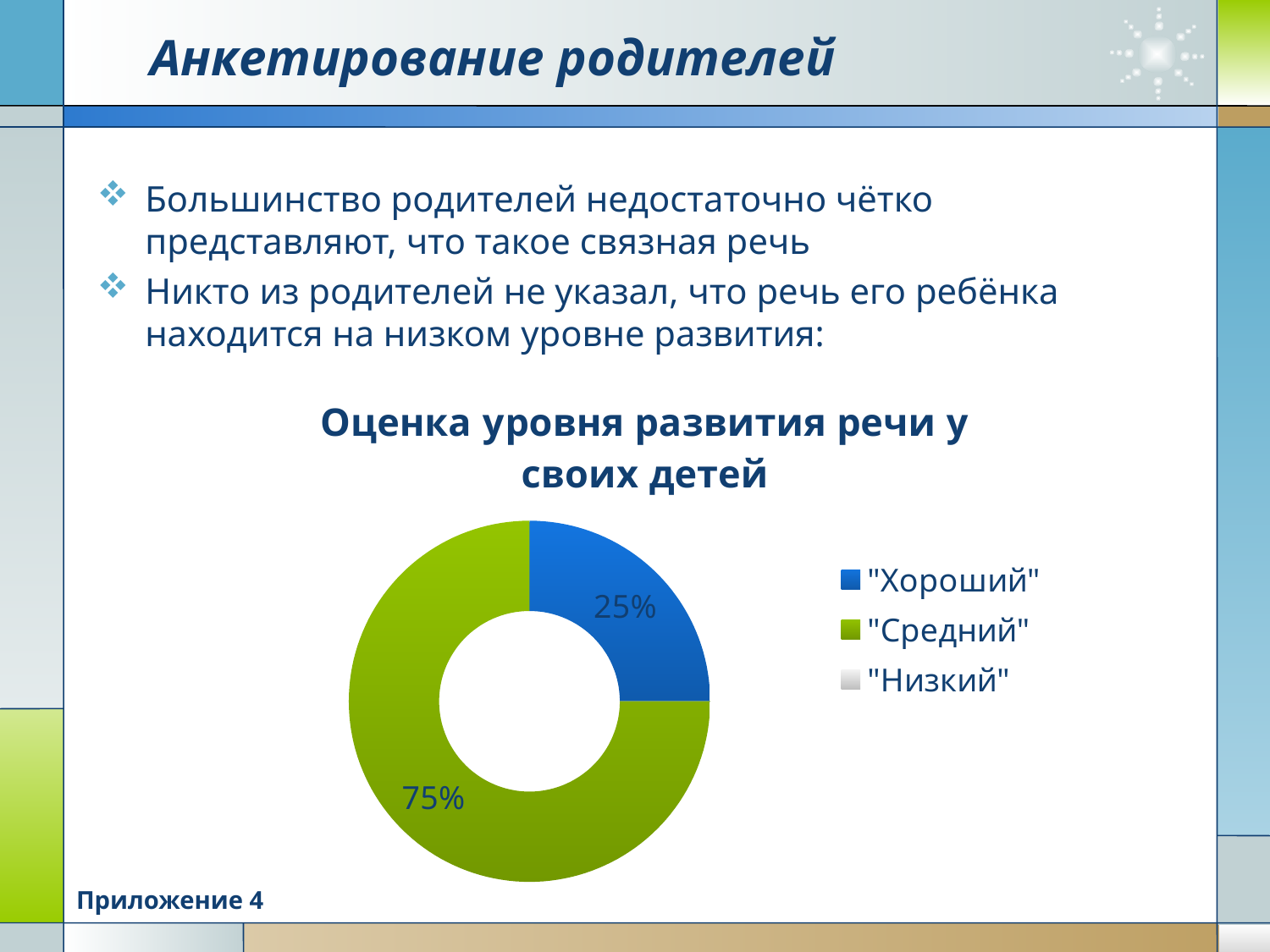
Which legend entry has no visible slice in the chart? "Низкий" Which category has the largest share of the chart? "Средний" What share of the chart does the "Средний" slice take? 75% By how many percentage points does the "Средний" share exceed the "Хороший" share? 50 percentage points What percentage of the chart is labelled for "Средний"? 75% How many slices with printed percentage labels are visible in the chart? 2 What percentage of the chart is labelled for "Хороший"? 25% What kind of chart is shown on the slide? Doughnut (pie) chart Which is larger, the share for "Хороший" or the share for "Средний"? "Средний" How many entries does the chart legend list? 3 Which legend entry is shown in blue? "Хороший" What is the title of the chart? Оценка уровня развития речи у своих детей